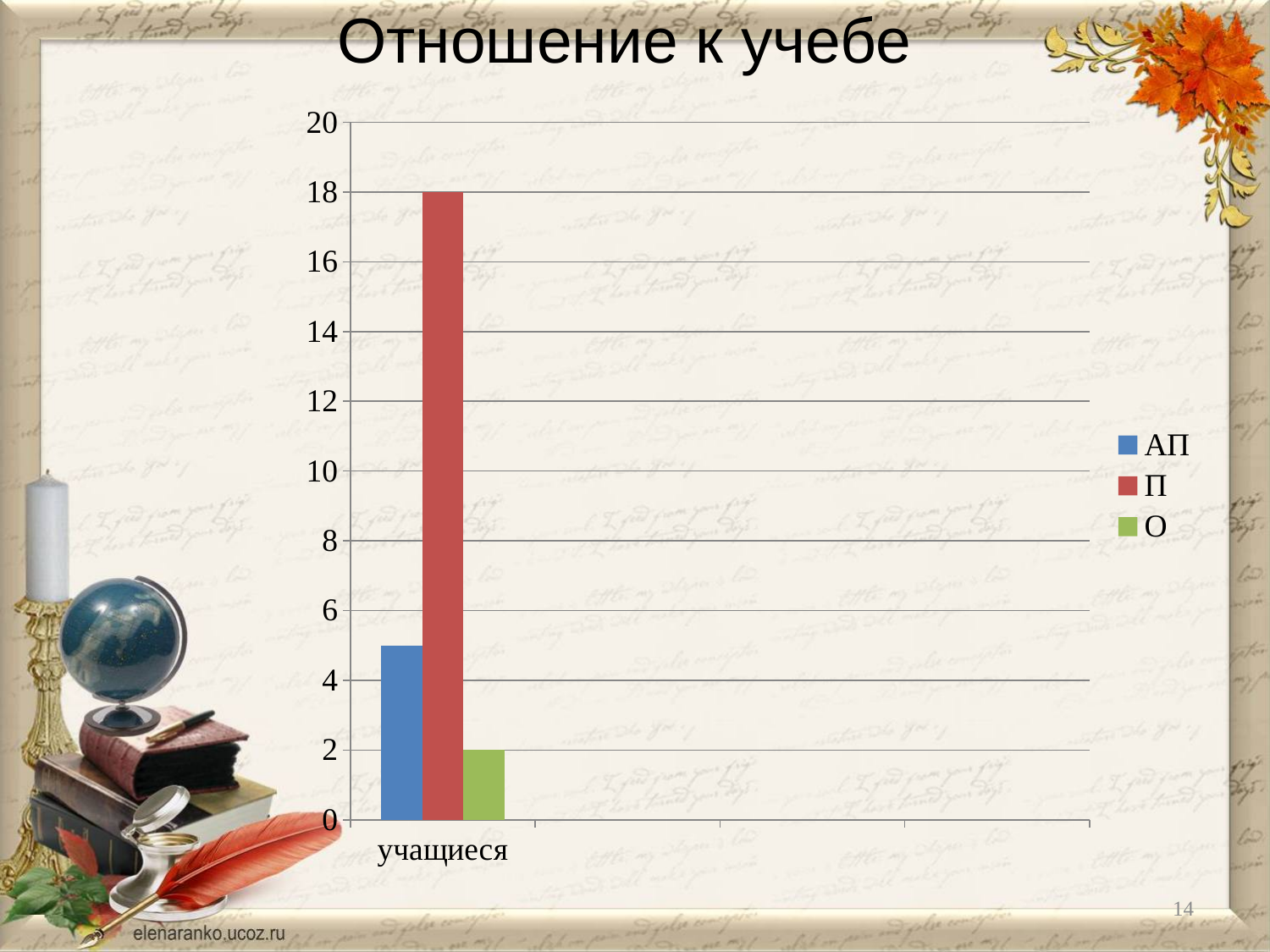
What is the title of the chart? Отношение к учебе What colour represents the П series in the legend? red What is the value of the О series for учащиеся? 2 Is the value of the АП series for учащиеся greater or less than 6? less What is the difference between the П value and the О value for учащиеся? 16 Which series has the highest value for учащиеся? П Which series has the lowest value for учащиеся? О How many series does the legend list? 3 Is the value of the АП series for учащиеся greater or less than 4? greater What kind of chart is shown on the slide? bar chart What is the value of the П series for учащиеся? 18 Which is larger for учащиеся, the АП series or the О series? АП